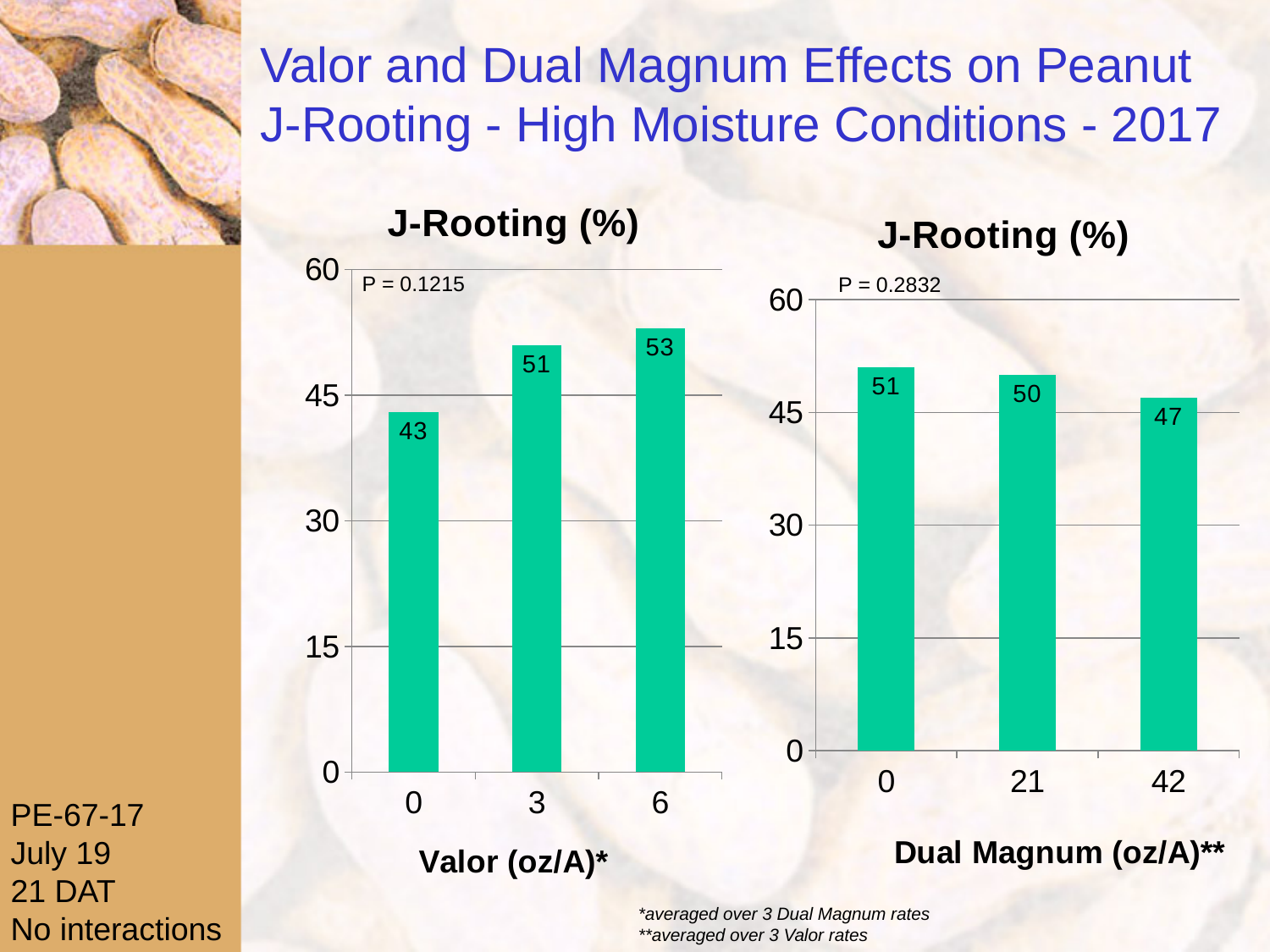
In the right chart (Dual Magnum), do the J-Rooting (%) values rise or fall as the rate increases from 0 to 42 oz/A? fall In the left chart (Valor), is the J-Rooting (%) value at 0 oz/A greater or less than 45? less In the right chart (Dual Magnum), what is the difference in J-Rooting (%) between the 0 oz/A and 42 oz/A rates? 4 In the left chart (Valor), what is the difference in J-Rooting (%) between the 6 oz/A and 0 oz/A rates? 10 In the left chart (Valor), what is the J-Rooting (%) value at the 0 oz/A rate? 43 In the left chart (Valor), which rate has the highest J-Rooting (%)? 6 In the right chart (Dual Magnum), which rate has the lowest J-Rooting (%)? 42 In the right chart (Dual Magnum), what is the J-Rooting (%) value at the 42 oz/A rate? 47 How many bars are shown in the right chart (Dual Magnum)? 3 In the left chart (Valor), what is the J-Rooting (%) value at the 6 oz/A rate? 53 What kind of chart is the left chart (Valor)? bar chart In the right chart (Dual Magnum), what is the J-Rooting (%) value at the 21 oz/A rate? 50